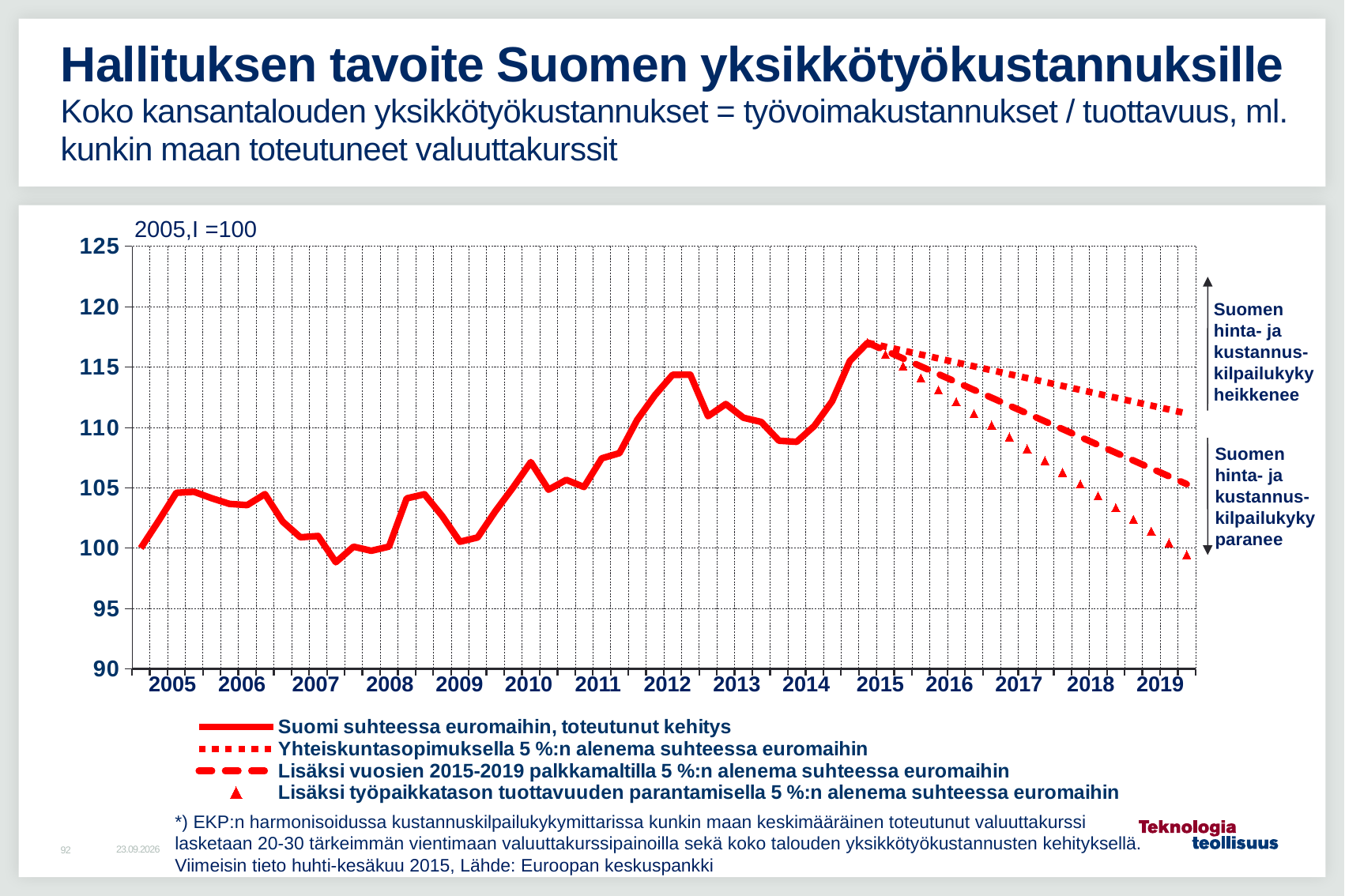
Is the value of the dotted line (Yhteiskuntasopimuksella 5 %:n alenema) at the end of 2019 greater or less than 110? greater Is the value of the triangle series at the end of 2018 greater or less than 100? greater Do the three projected series (dotted, dashed and triangles) rise or fall from 2015 to 2019? fall Is the peak value of the solid line in 2015 greater or less than 115? greater Which peak of the solid line is higher, the one in 2010 or the one in 2012? 2012 What base period note is printed above the y axis? 2005,I =100 How many years are labelled on the x axis? 15 Which is higher at the end of 2019, the dotted line or the dashed line? the dotted line How many series does the legend list? 4 What kind of chart is shown on the slide? line chart What is the index value of the solid line at the start of 2005? 100 In which year does the solid line (Suomi suhteessa euromaihin, toteutunut kehitys) reach its highest value? 2015